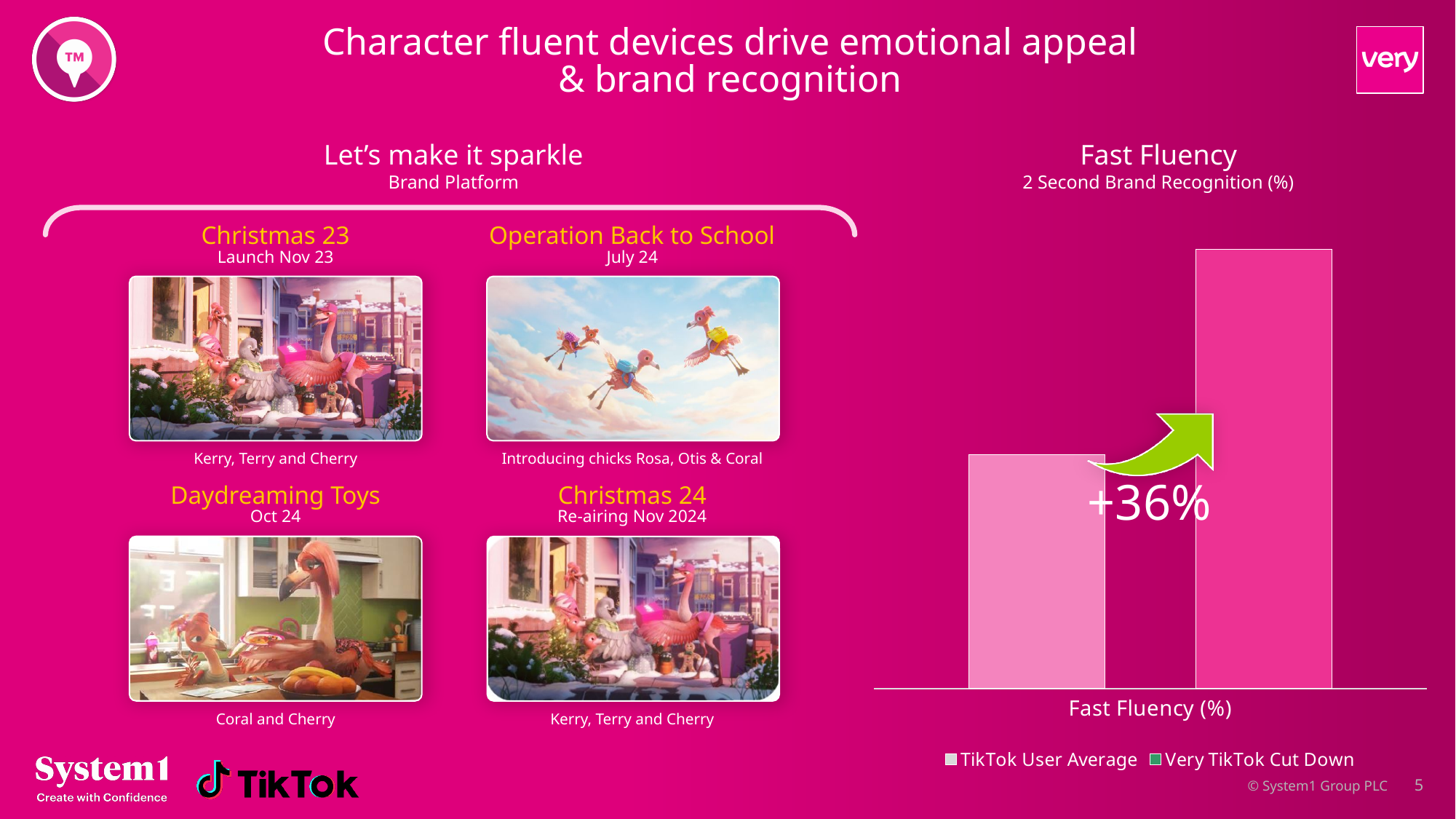
What percentage change is annotated next to the arrow on the Fast Fluency chart? +36% How many categories are shown on the x axis of the Fast Fluency chart? 1 What is the category label on the x axis of the Fast Fluency chart? Fast Fluency (%) In the Fast Fluency chart, which series has the highest value? Very TikTok Cut Down In the Fast Fluency chart, which series has the taller bar: TikTok User Average or Very TikTok Cut Down? Very TikTok Cut Down In the Fast Fluency chart, which series has the lowest value? TikTok User Average What kind of chart is shown under the 'Fast Fluency' heading? bar chart How many series does the legend of the Fast Fluency chart list? 2